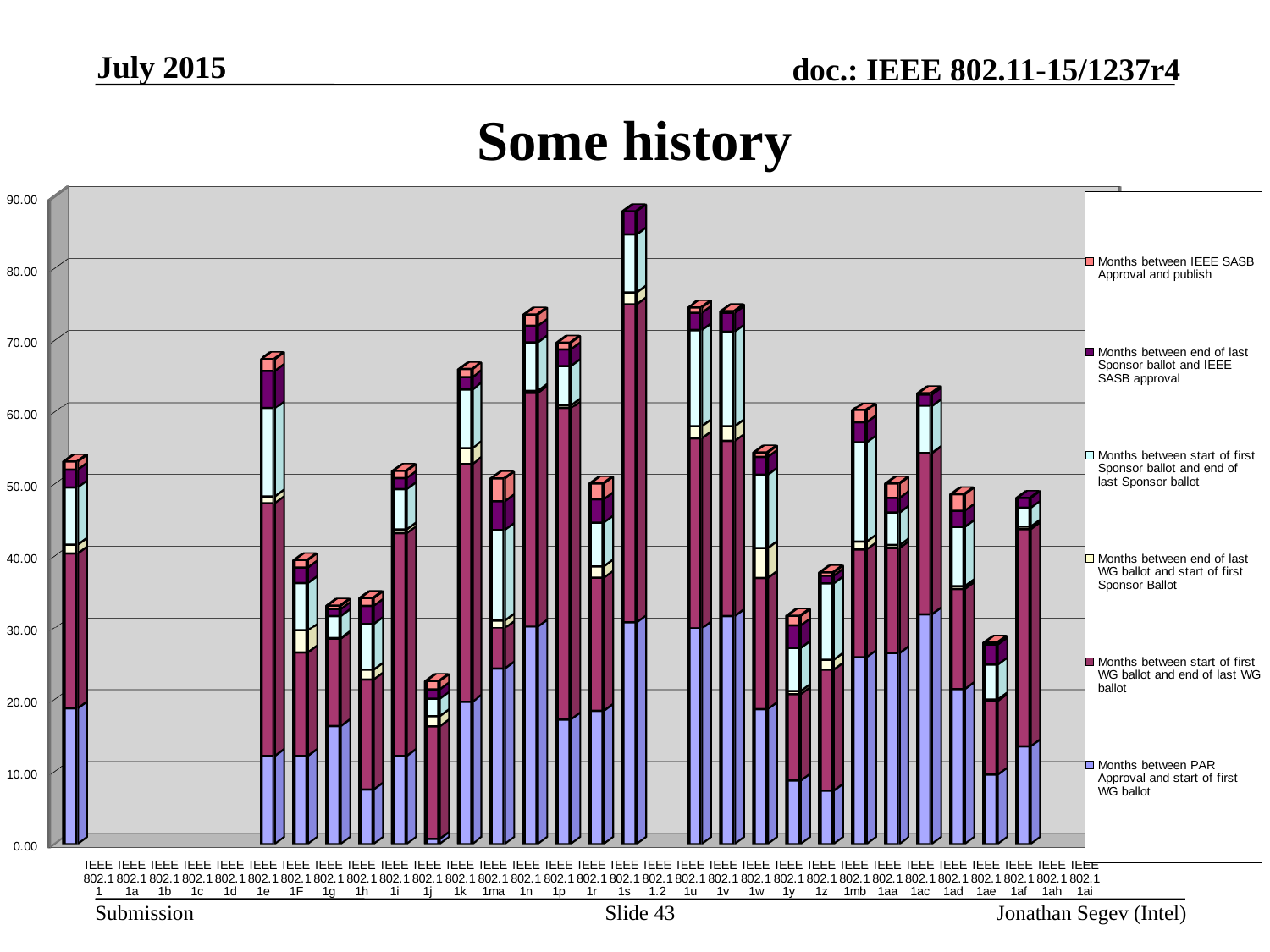
Is the total for IEEE 802.11g greater or less than 40.00? less Is the total for IEEE 802.11j greater or less than 30.00? less Which has the taller stacked bar, IEEE 802.11k or IEEE 802.11ma? IEEE 802.11k Which has the taller stacked bar, IEEE 802.11e or IEEE 802.11F? IEEE 802.11e Which category has the tallest stacked bar? IEEE 802.11s Is the total for IEEE 802.11s greater or less than 80.00? greater Which legend entry is listed last (at the bottom of the legend)? Months between PAR Approval and start of first WG ballot How many series does the legend list? 6 What is the title of the chart? Some history Among the categories with a plotted bar, which has the shortest stacked bar? IEEE 802.11j What kind of chart is shown on the slide? Stacked bar chart